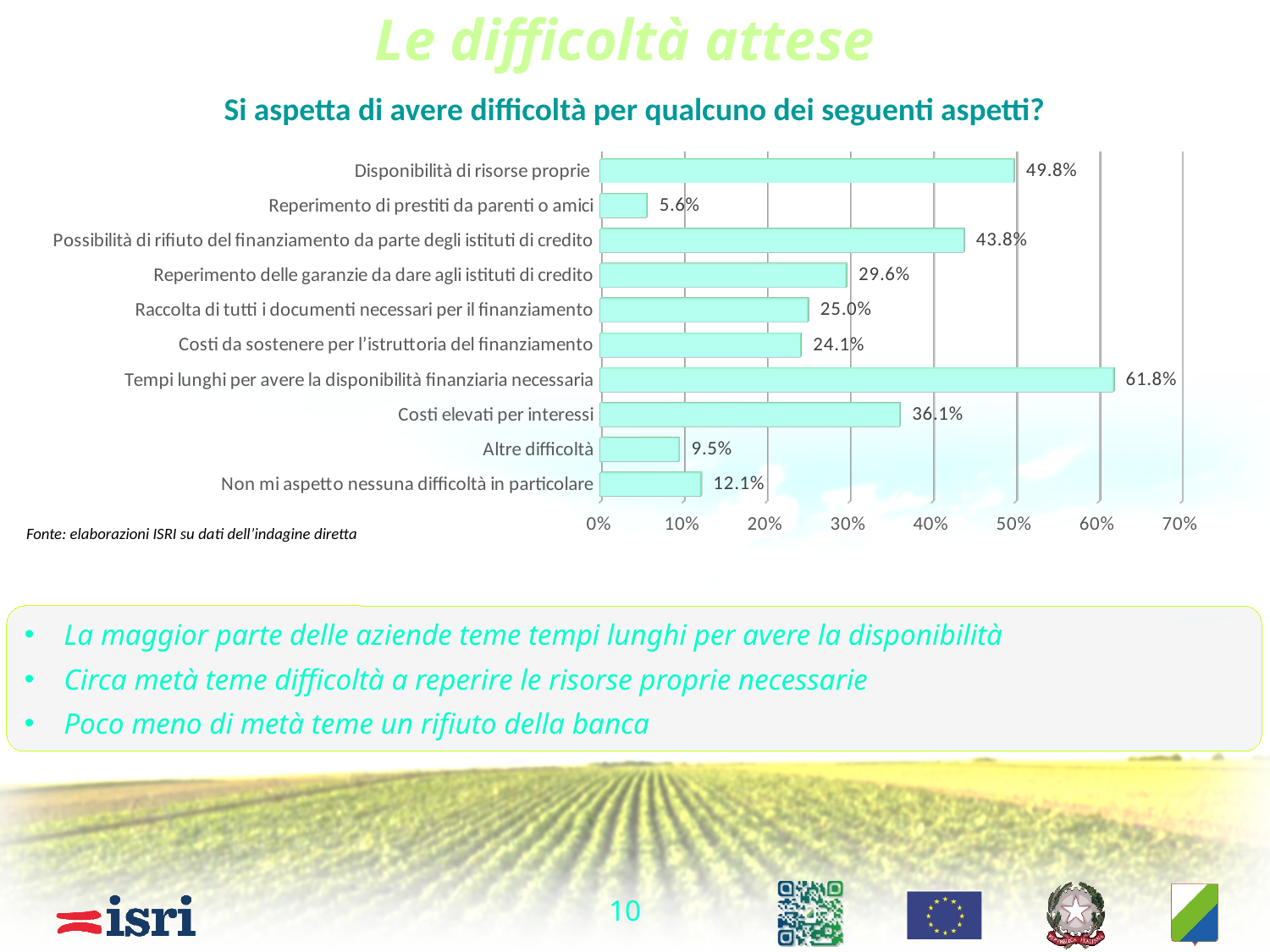
Which category has the highest value? Tempi lunghi per avere la disponibilità finanziaria necessaria How many categories are shown in the chart? 10 What is the difference between the values for "Disponibilità di risorse proprie" and "Possibilità di rifiuto del finanziamento da parte degli istituti di credito"? 6.0 percentage points Which category has the lowest value? Reperimento di prestiti da parenti o amici What type of chart is shown on the slide? Bar chart What is the question shown as the chart's title? Si aspetta di avere difficoltà per qualcuno dei seguenti aspetti? What is the value for "Tempi lunghi per avere la disponibilità finanziaria necessaria"? 61.8% What is the difference between the values for "Tempi lunghi per avere la disponibilità finanziaria necessaria" and "Disponibilità di risorse proprie"? 12.0 percentage points What is the value for "Non mi aspetto nessuna difficoltà in particolare"? 12.1% Which is larger: the value for "Costi elevati per interessi" or the value for "Reperimento delle garanzie da dare agli istituti di credito"? Costi elevati per interessi What is the value for "Reperimento di prestiti da parenti o amici"? 5.6% What is the value for "Costi elevati per interessi"? 36.1%